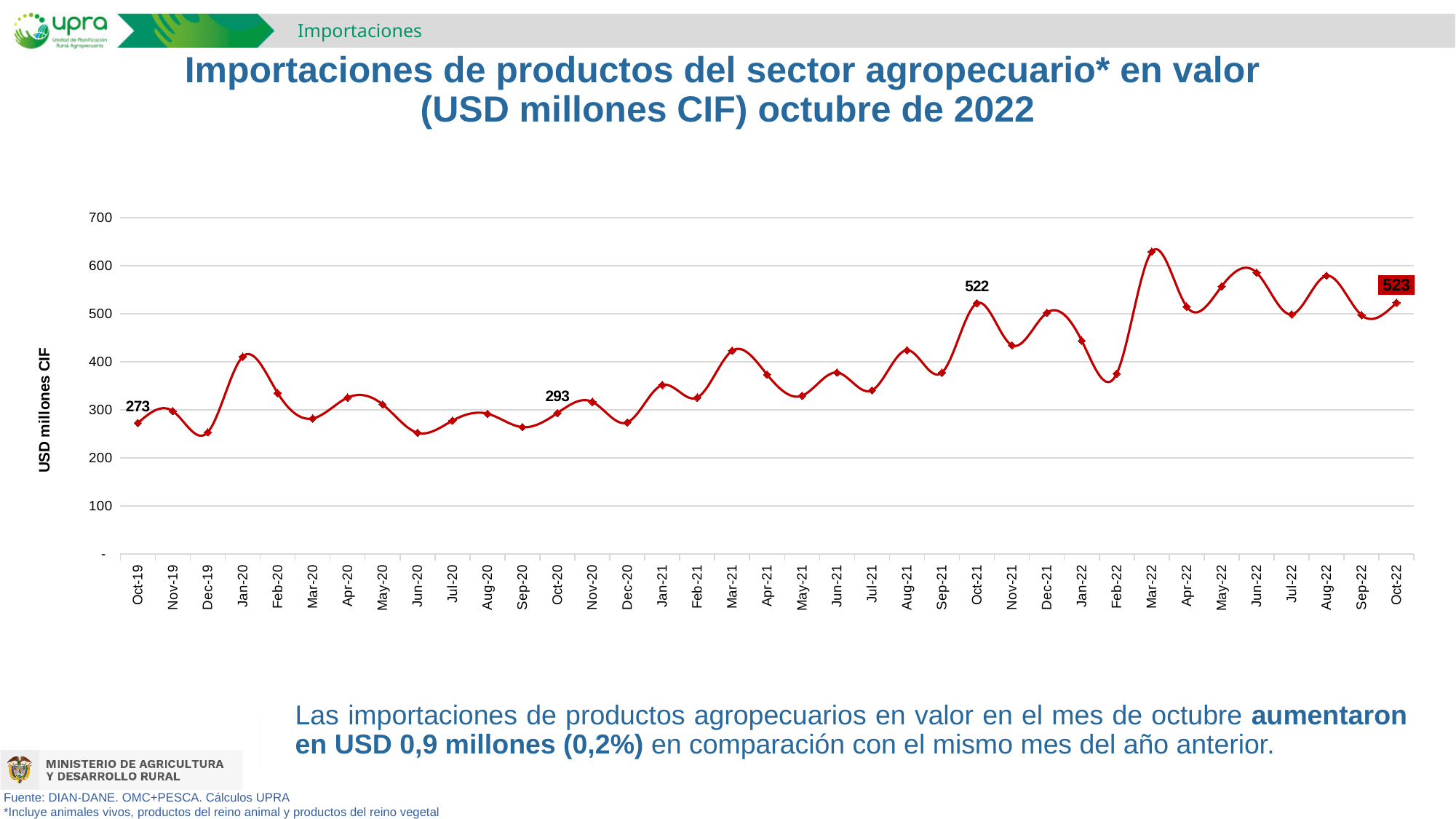
Which is larger, the value for Oct-21 or the value for Oct-20? Oct-21 What is the value for Oct-19? 273 What is the value for Oct-21? 522 What kind of chart is shown on the slide? Line chart What is the difference between the values for Oct-20 and Oct-19? 20 Is the value for Mar-22 greater or less than 600? greater What is the difference between the values for Oct-21 and Oct-20? 229 Which month has the highest value on the chart? Mar-22 How many monthly data points are plotted on the chart? 37 What is the value for Oct-22? 523 What is the value for Oct-20? 293 Is the value for Jun-20 greater or less than 300? less